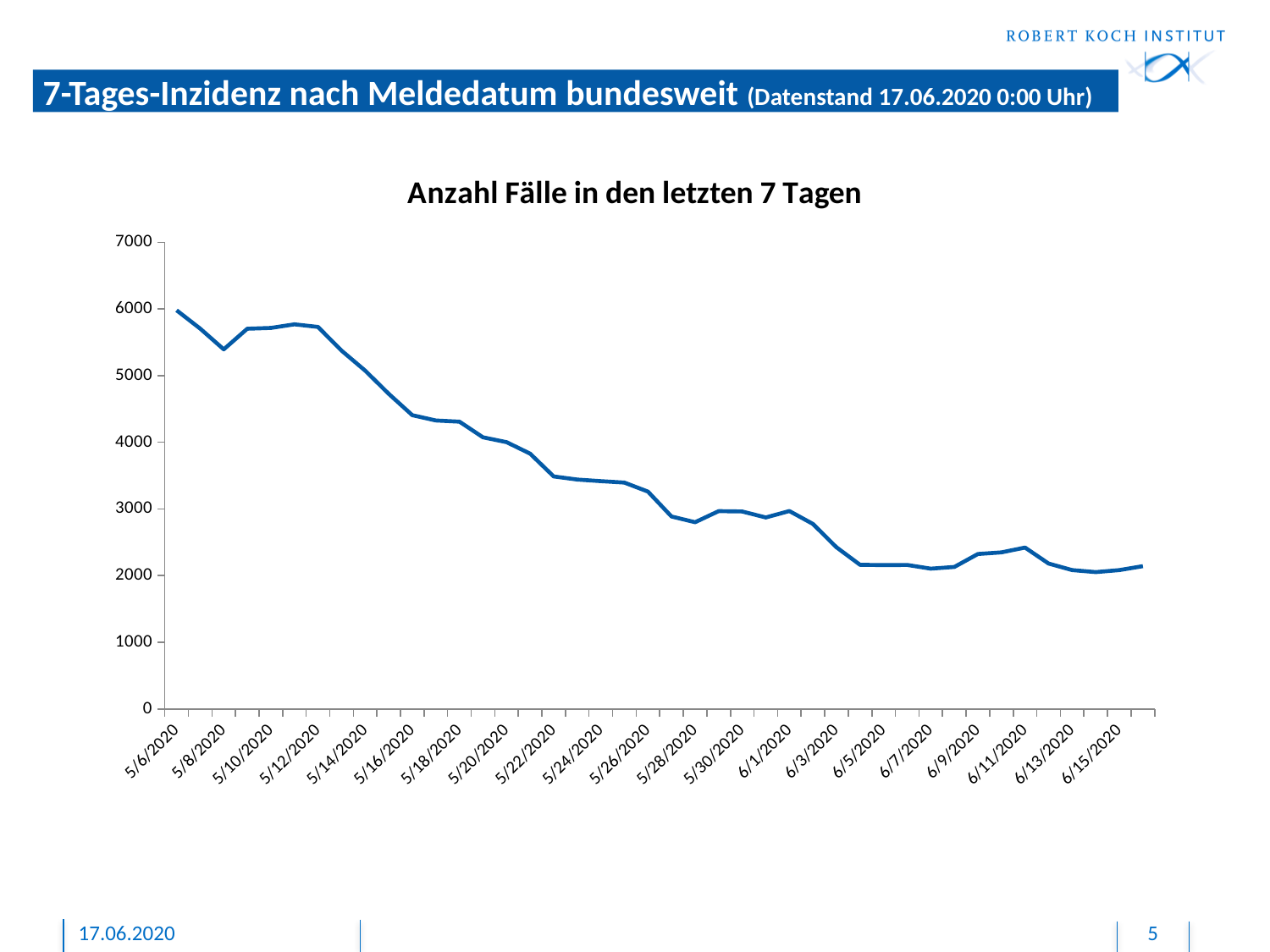
Is the value for 5/16/2020 greater or less than 4000? greater What is the title of the chart? Anzahl Fälle in den letzten 7 Tagen Is the value for 5/28/2020 greater or less than 3000? less How many date labels are shown on the x axis? 21 Is the value for 5/6/2020 greater or less than 5000? greater What kind of chart is shown on the slide? line chart What is the highest tick value shown on the y axis? 7000 Which is larger, the value for 5/10/2020 or the value for 5/20/2020? 5/10/2020 Do the values generally rise or fall from 5/6/2020 to 6/15/2020? fall Which date has the highest value on the chart? 5/6/2020